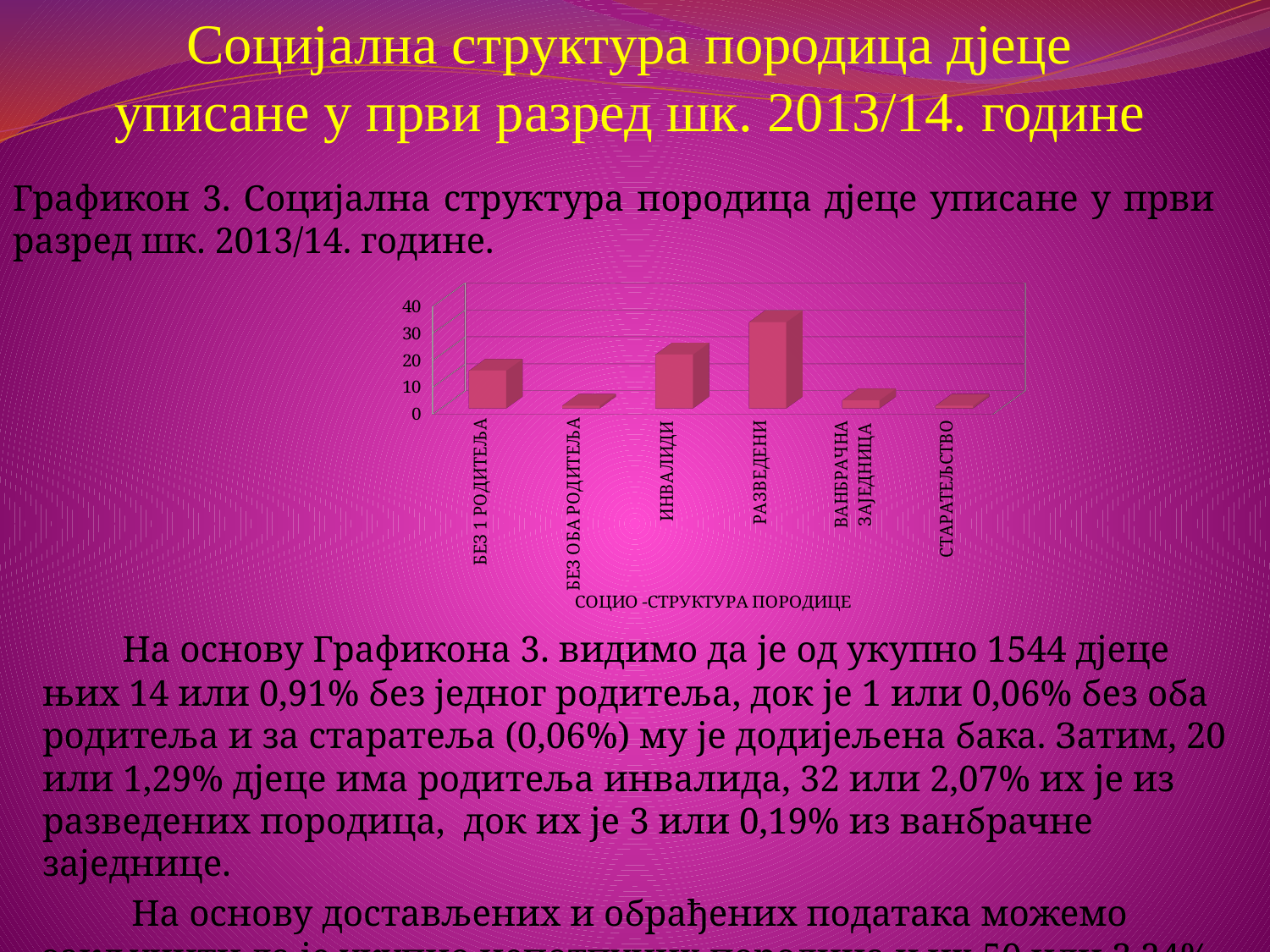
What is the title of the x axis of the chart? СОЦИО -СТРУКТУРА ПОРОДИЦЕ Is the value for ВАНБРАЧНА ЗАЈЕДНИЦА greater or less than 10? less Which category has the highest bar in the chart? РАЗВЕДЕНИ Is the value for БЕЗ 1 РОДИТЕЉА greater or less than 20? less What kind of chart is shown on the slide? bar chart Which is larger, the value for ИНВАЛИДИ or the value for БЕЗ ОБА РОДИТЕЉА? ИНВАЛИДИ Is the value for ИНВАЛИДИ greater or less than 10? greater Which is larger, the value for РАЗВЕДЕНИ or the value for ИНВАЛИДИ? РАЗВЕДЕНИ How many categories are shown on the x axis of the chart? 6 Which is larger, the value for БЕЗ 1 РОДИТЕЉА or the value for ВАНБРАЧНА ЗАЈЕДНИЦА? БЕЗ 1 РОДИТЕЉА What is the highest value shown on the vertical axis of the chart? 40